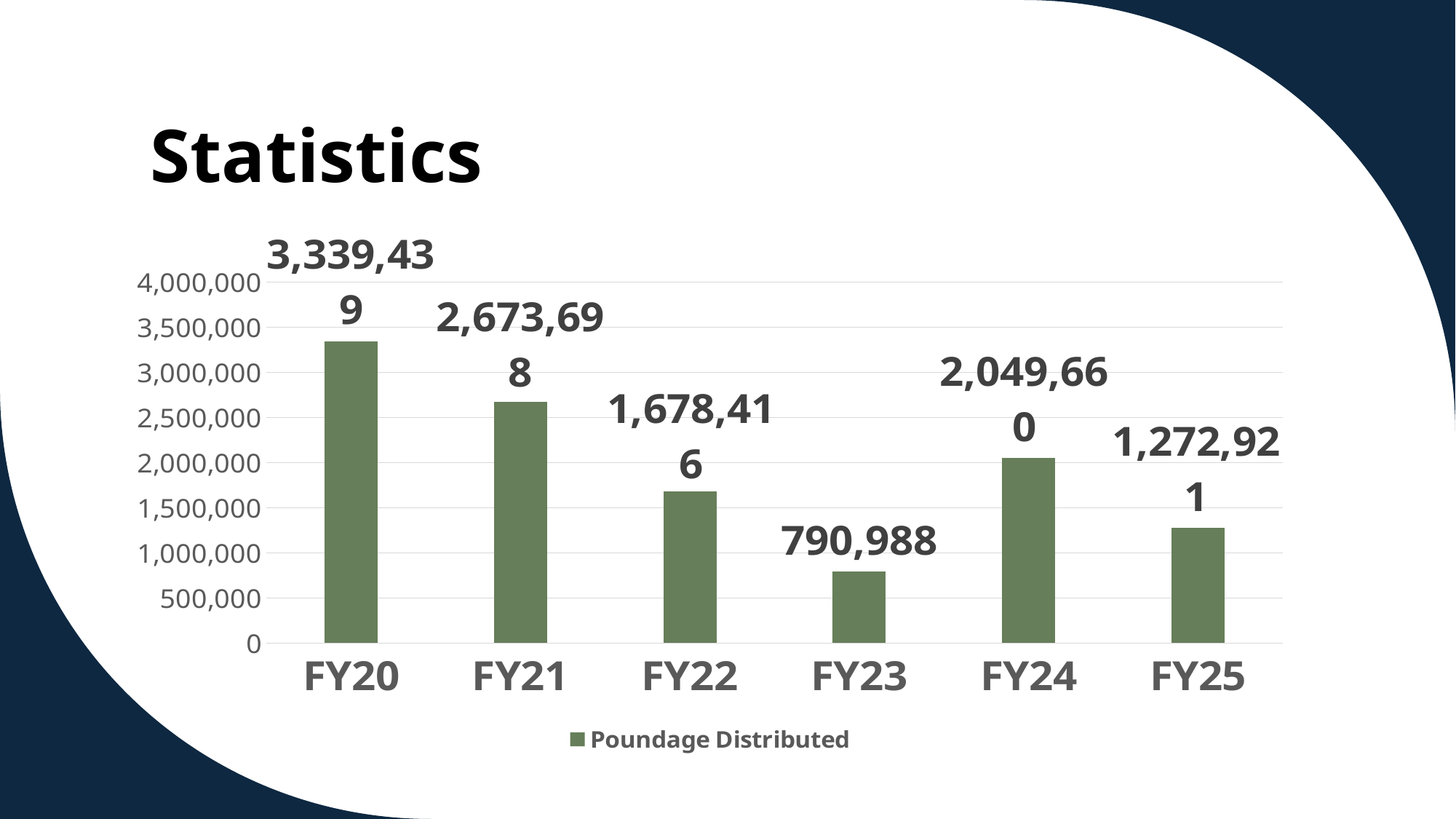
Which fiscal year has the highest Poundage Distributed? FY20 Is the Poundage Distributed for FY21 greater or less than 2,500,000? greater What is the Poundage Distributed value for FY25? 1,272,921 What is the difference in Poundage Distributed between FY20 and FY21? 665,741 How many fiscal years are shown on the x axis of the chart? 6 What is the Poundage Distributed value for FY23? 790,988 Which has a larger Poundage Distributed, FY22 or FY24? FY24 What is the difference in Poundage Distributed between FY24 and FY23? 1,258,672 What series name does the chart legend show? Poundage Distributed What is the Poundage Distributed value for FY20? 3,339,439 What type of chart is shown on the slide? bar chart Which fiscal year has the lowest Poundage Distributed? FY23